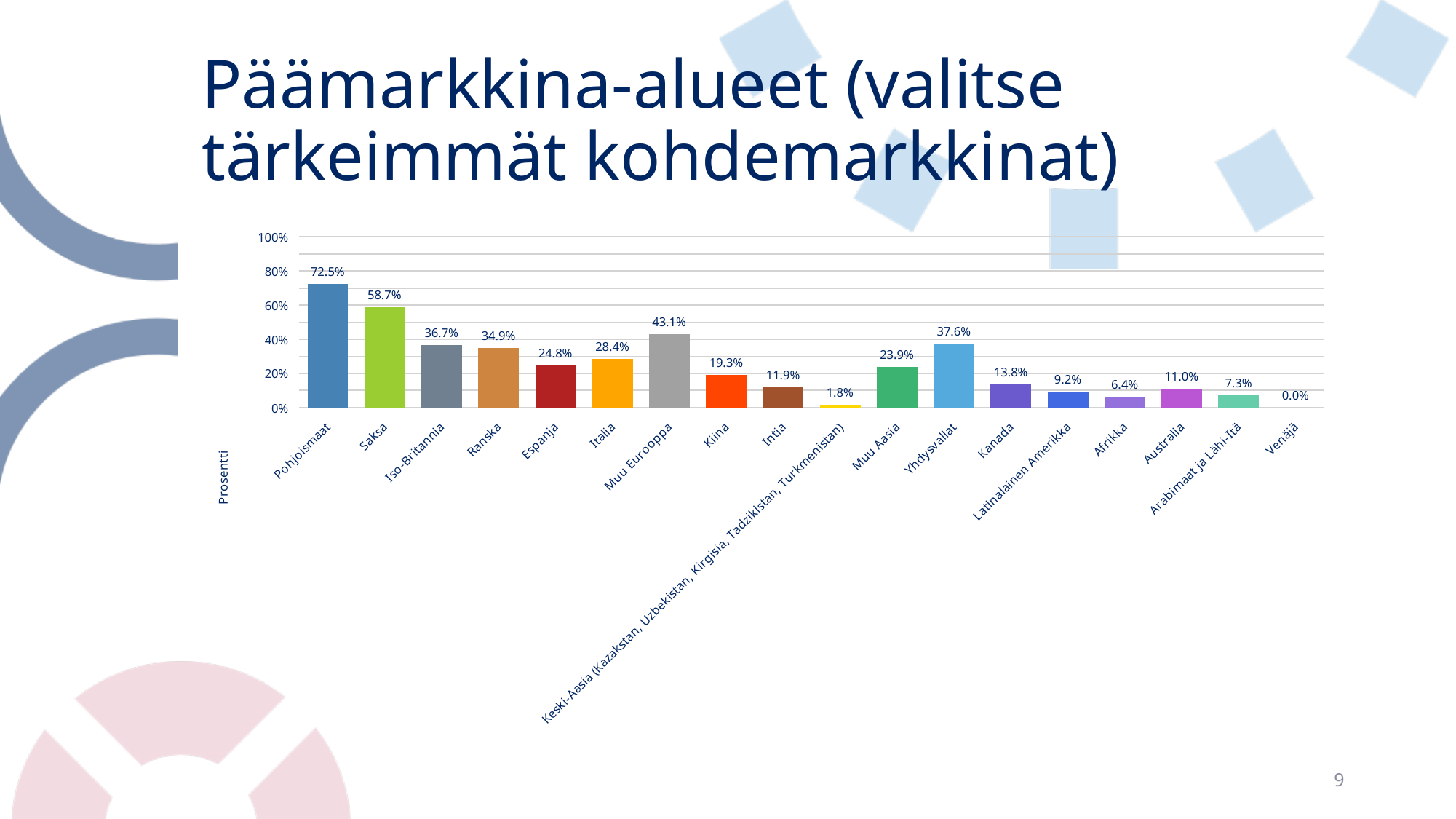
Which category has the lowest value? Venäjä Is the value for Saksa greater or less than 40%? greater What is the difference between the values for Pohjoismaat and Saksa? 13.8% What is the value for Yhdysvallat? 37.6% How many categories are shown on the x axis? 18 What is the value for Pohjoismaat? 72.5% What is the difference between the values for Iso-Britannia and Ranska? 1.8% Which is larger, the value for Kiina or the value for Muu Aasia? Muu Aasia What is the value for Muu Eurooppa? 43.1% What kind of chart is shown on the slide? bar chart What is the value for Keski-Aasia (Kazakstan, Uzbekistan, Kirgisia, Tadzikistan, Turkmenistan)? 1.8% Which category has the highest value? Pohjoismaat